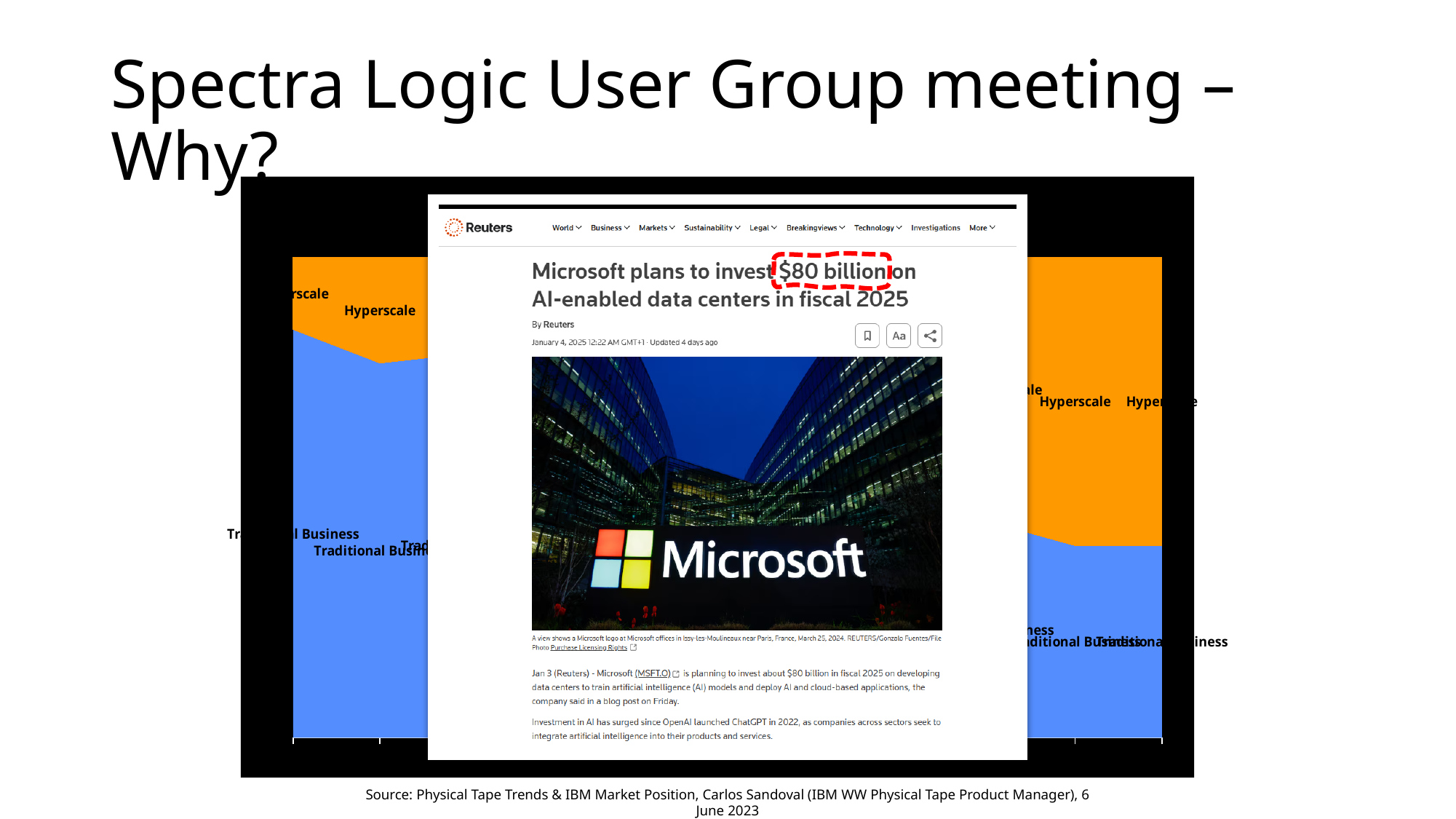
At the right edge of the chart, which series occupies the larger area: Hyperscale or Traditional Business? Hyperscale What kind of chart is shown behind the news article on the slide? Stacked area chart Does the Hyperscale area grow or shrink from the left side of the chart to the right side? Grow Which series is shown in orange on the chart? Hyperscale At the left edge of the chart, which series occupies the larger area: Hyperscale or Traditional Business? Traditional Business How many data series are labelled on the chart behind the article? 2 Which series is shown in blue on the chart? Traditional Business Does the Traditional Business area grow or shrink from the left side of the chart to the right side? Shrink